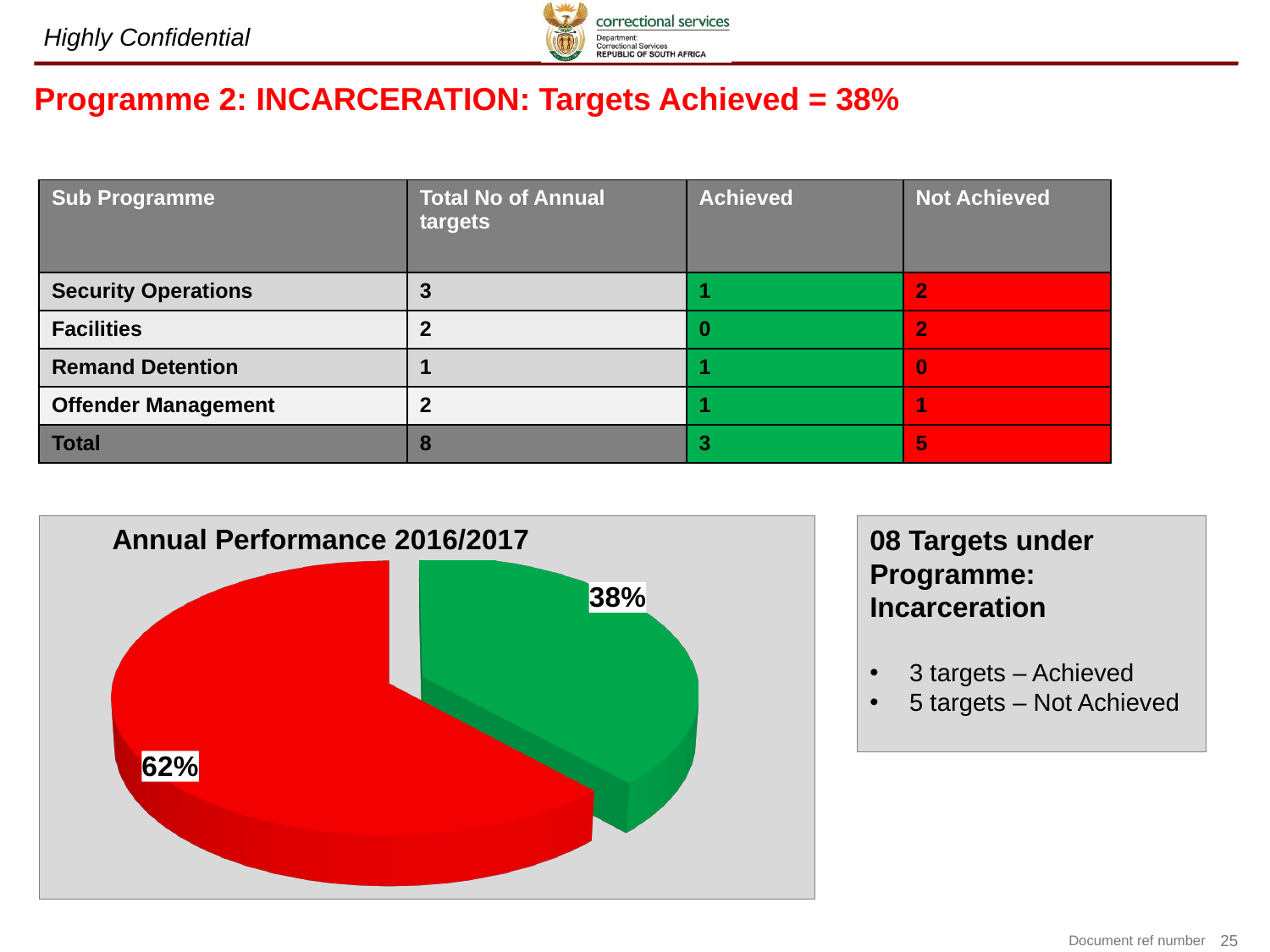
What colour is the slice labelled 38%? green Is the red slice or the green slice larger? the red slice What percentage is shown on the green slice of the pie chart? 38% What kind of chart is shown on the slide? pie chart What is the difference in percentage points between the red slice and the green slice? 24 Which slice of the pie chart is the largest? the red slice (62%) How many slices does the pie chart have? 2 What is the title of the chart? Annual Performance 2016/2017 What share of the pie represents targets not achieved? 62% Which slice of the pie chart is the smallest? the green slice (38%) What percentage is shown on the red slice of the pie chart? 62% What share of the pie represents targets achieved? 38%